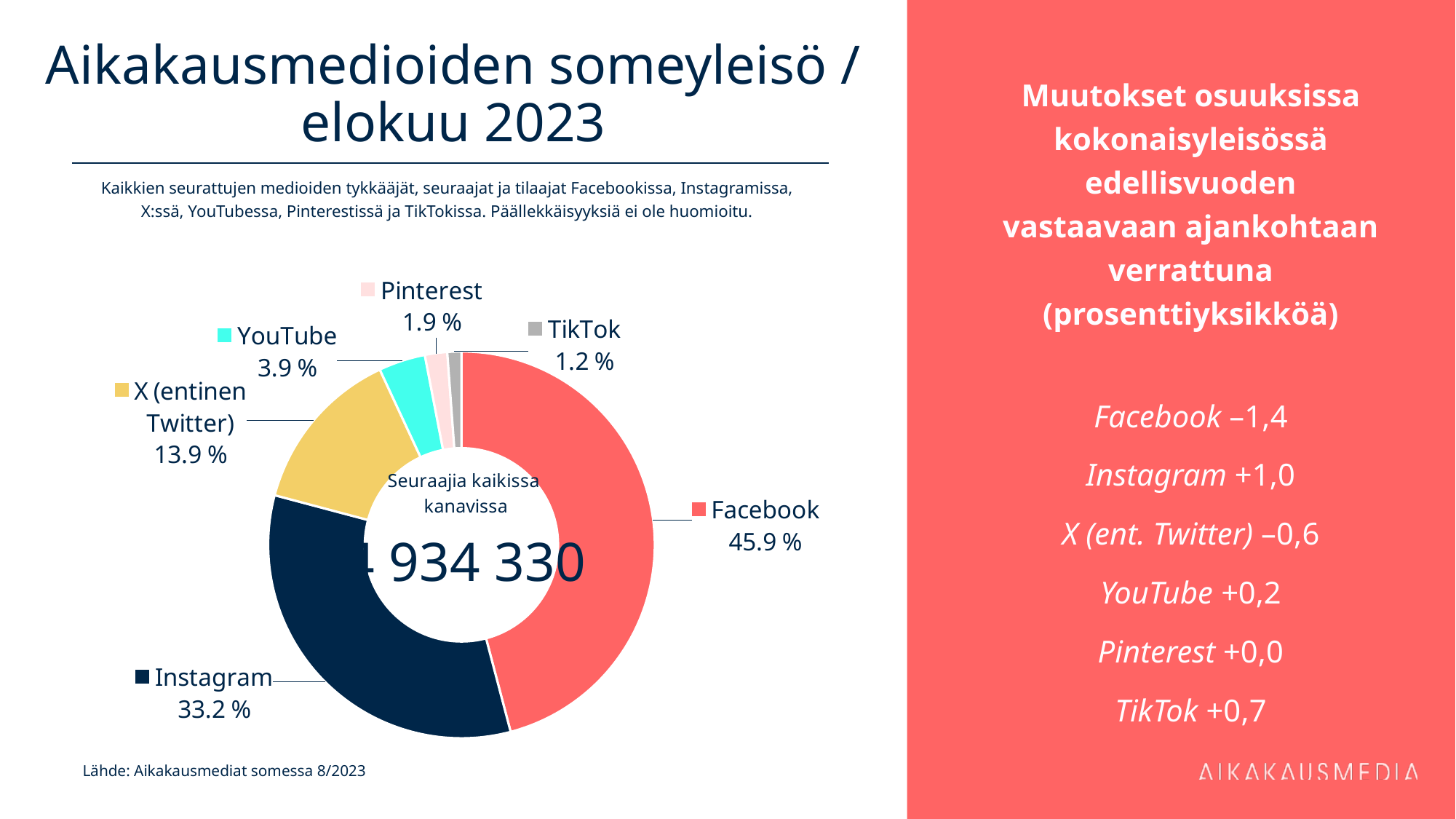
How many categories are shown in the chart? 6 What colour is the Instagram segment in the chart? Dark navy blue What percentage is shown for X (entinen Twitter)? 13.9 % What is the combined share of YouTube, Pinterest and TikTok? 7.0 % What type of chart is shown on the slide? Doughnut chart What is the difference in percentage points between Facebook and Instagram? 12.7 What is the value shown for YouTube in the chart? 3.9 % What share of the doughnut chart does Facebook account for? 45.9 % Which category has the smallest share in the chart? TikTok Which category has the largest share in the chart? Facebook What is the value shown for Instagram in the chart? 33.2 % Which has a larger share, Pinterest or TikTok? Pinterest